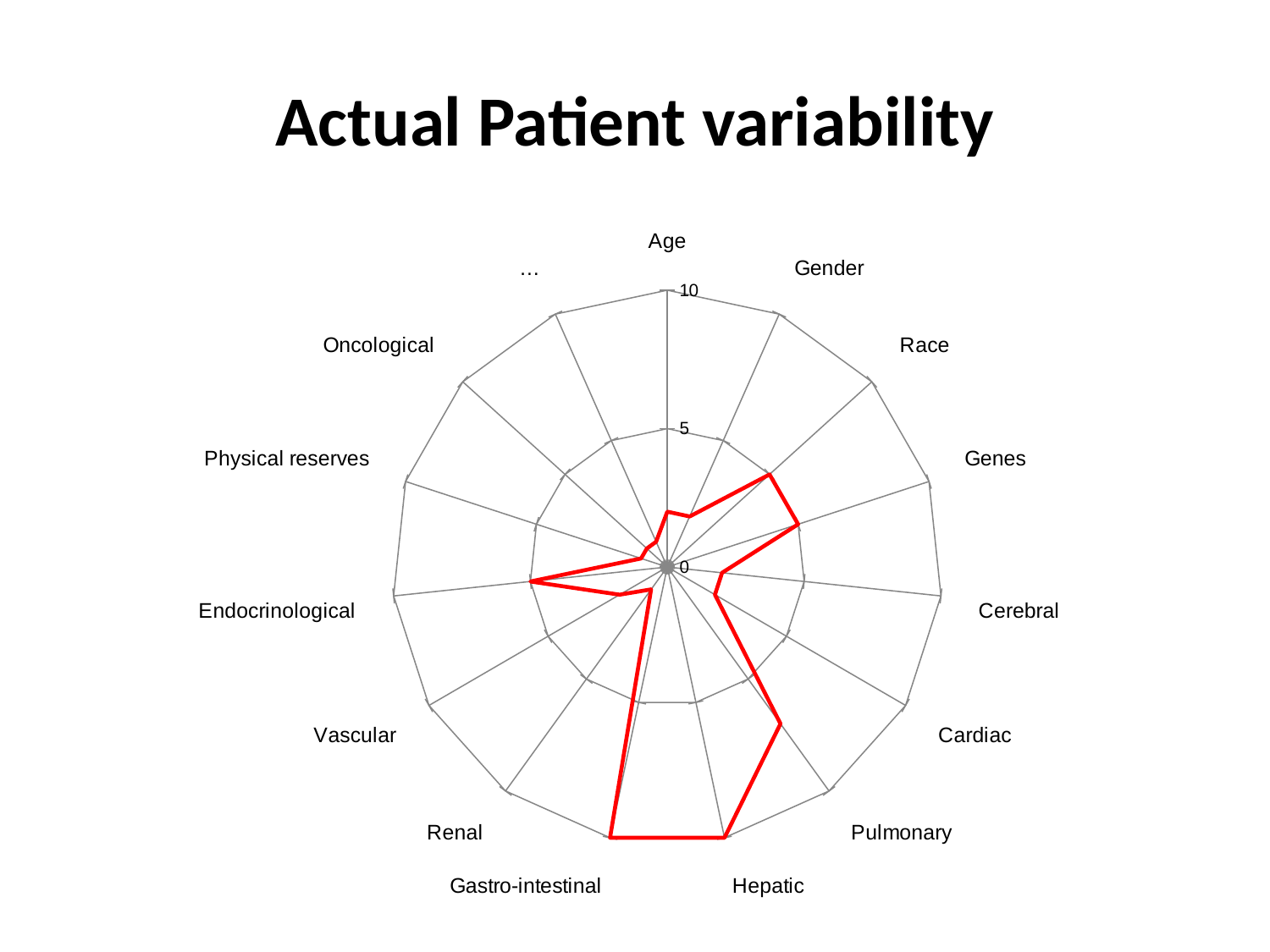
What is the maximum value shown on the chart's axis scale? 10 Is the value for Oncological greater or less than 5? less Is the value for Cerebral greater or less than 5? less What is the value for Gastro-intestinal? 10 How many categories (axes) does the radar chart have? 15 Which has the larger value, Pulmonary or Age? Pulmonary Is the value for Pulmonary greater or less than 5? greater Which has the larger value, Hepatic or Vascular? Hepatic What is the value for Hepatic? 10 What kind of chart is shown on the slide? radar chart What is the title of the chart? Actual Patient variability